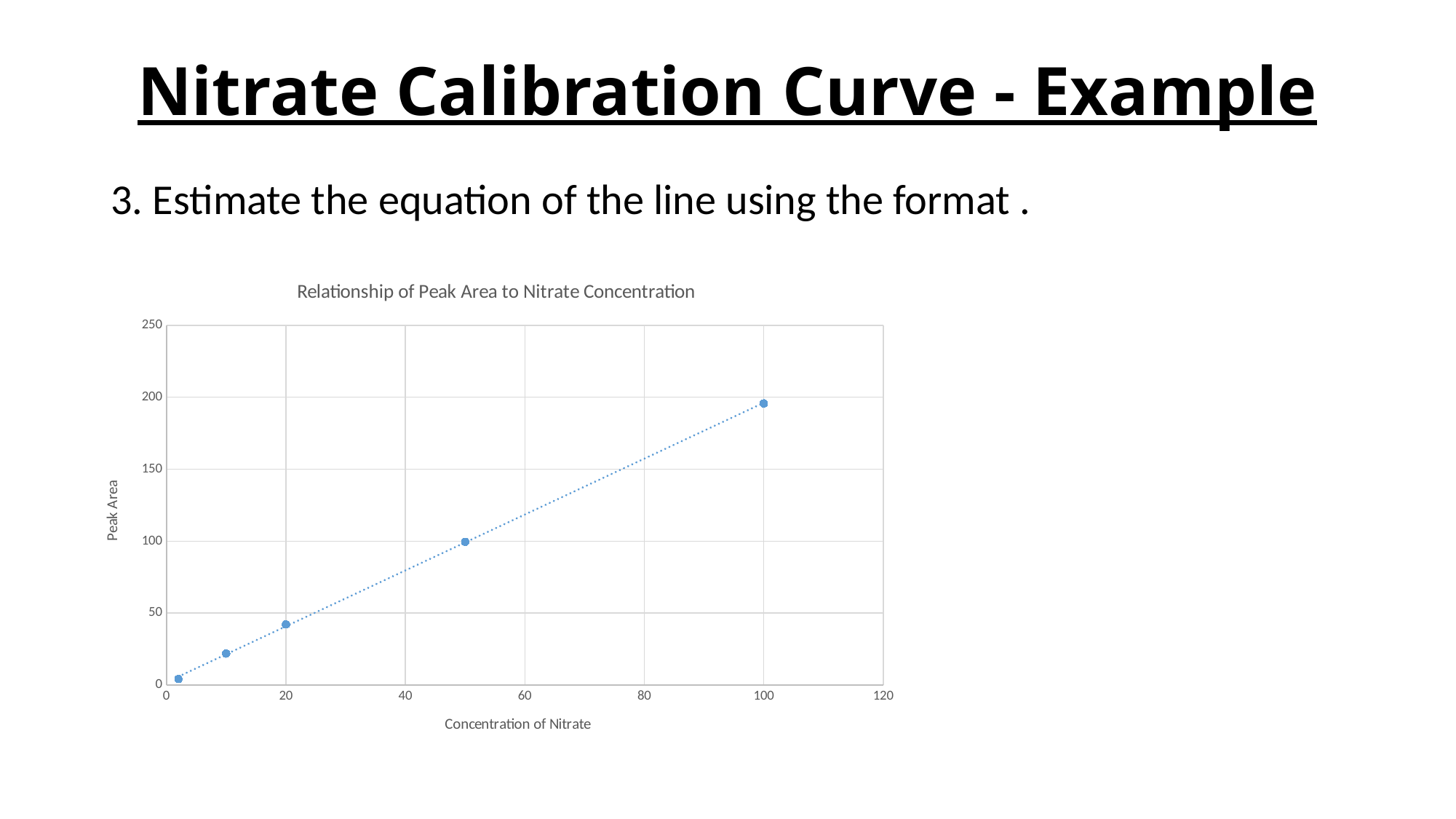
At which concentration of nitrate is the peak area highest? 100 Is the peak area at a nitrate concentration of 20 greater or less than 50? less What kind of chart is shown on the slide? Scatter chart Is the peak area at a nitrate concentration of 100 greater or less than 150? greater How many data points are plotted on the chart? 5 What is the highest value shown on the vertical axis of the chart? 250 Is the peak area at a nitrate concentration of 10 greater or less than 50? less Does peak area rise or fall as the concentration of nitrate increases? Rises What is the label of the vertical axis of the chart? Peak Area What is the title of the chart? Relationship of Peak Area to Nitrate Concentration Which has the larger peak area: the point at a concentration of 50 or the point at a concentration of 100? 100